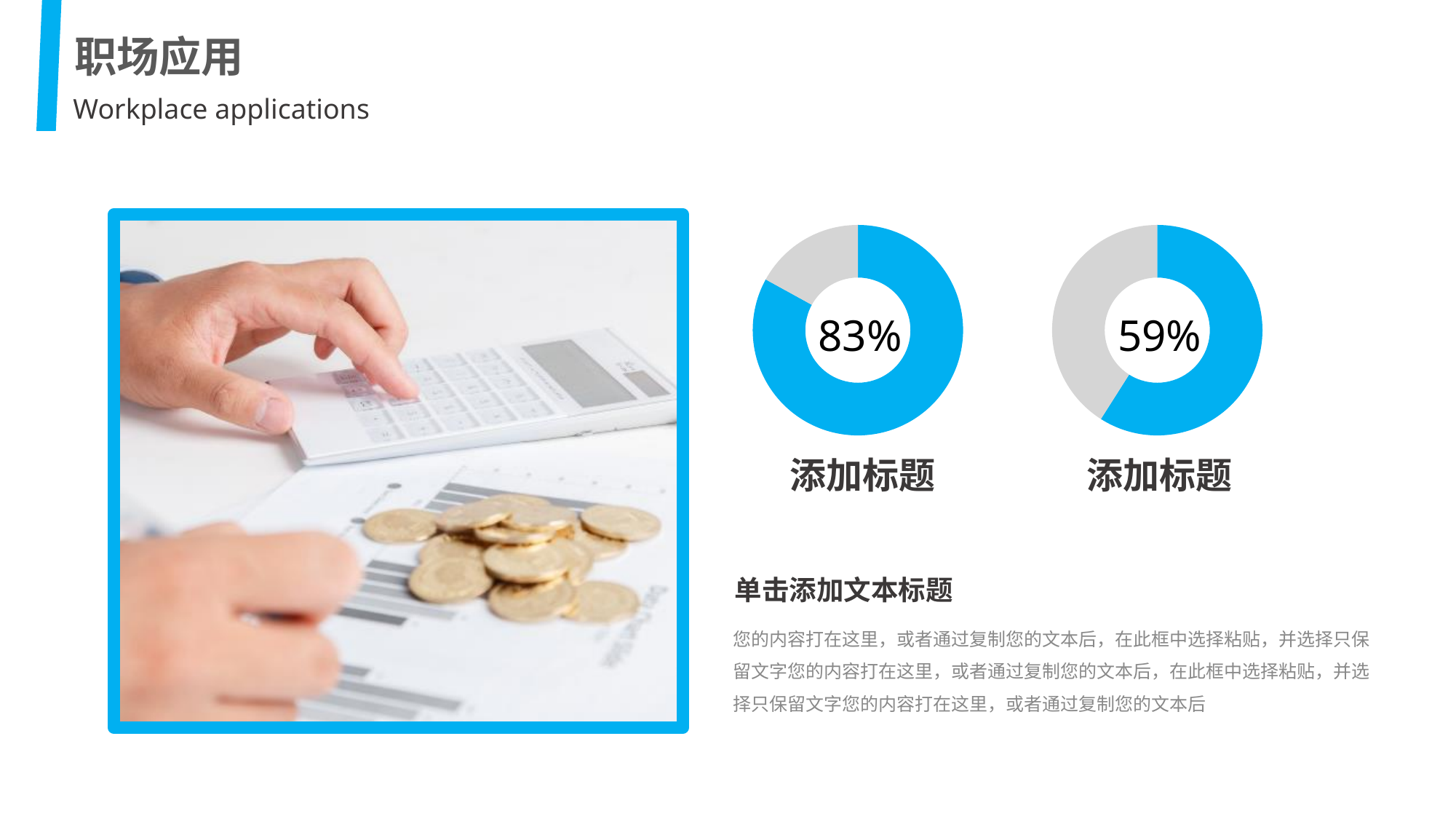
What share of the left donut chart is not filled in blue? 17% What kind of chart is used on the right side of the slide to show 83% and 59%? donut chart What share of the right donut chart is grey? 41% Is the value shown in the right donut chart greater or less than 50%? greater What percentage is shown in the centre of the right donut chart? 59% What colour is the filled portion of each donut chart? blue What is the label printed below each donut chart? 添加标题 What is the difference between the percentages shown in the left and right donut charts? 24% Is the value shown in the left donut chart greater or less than 80%? greater How many donut charts are on the slide? 2 Which of the two donut charts shows the higher percentage, the left or the right? left What percentage is shown in the centre of the left donut chart? 83%